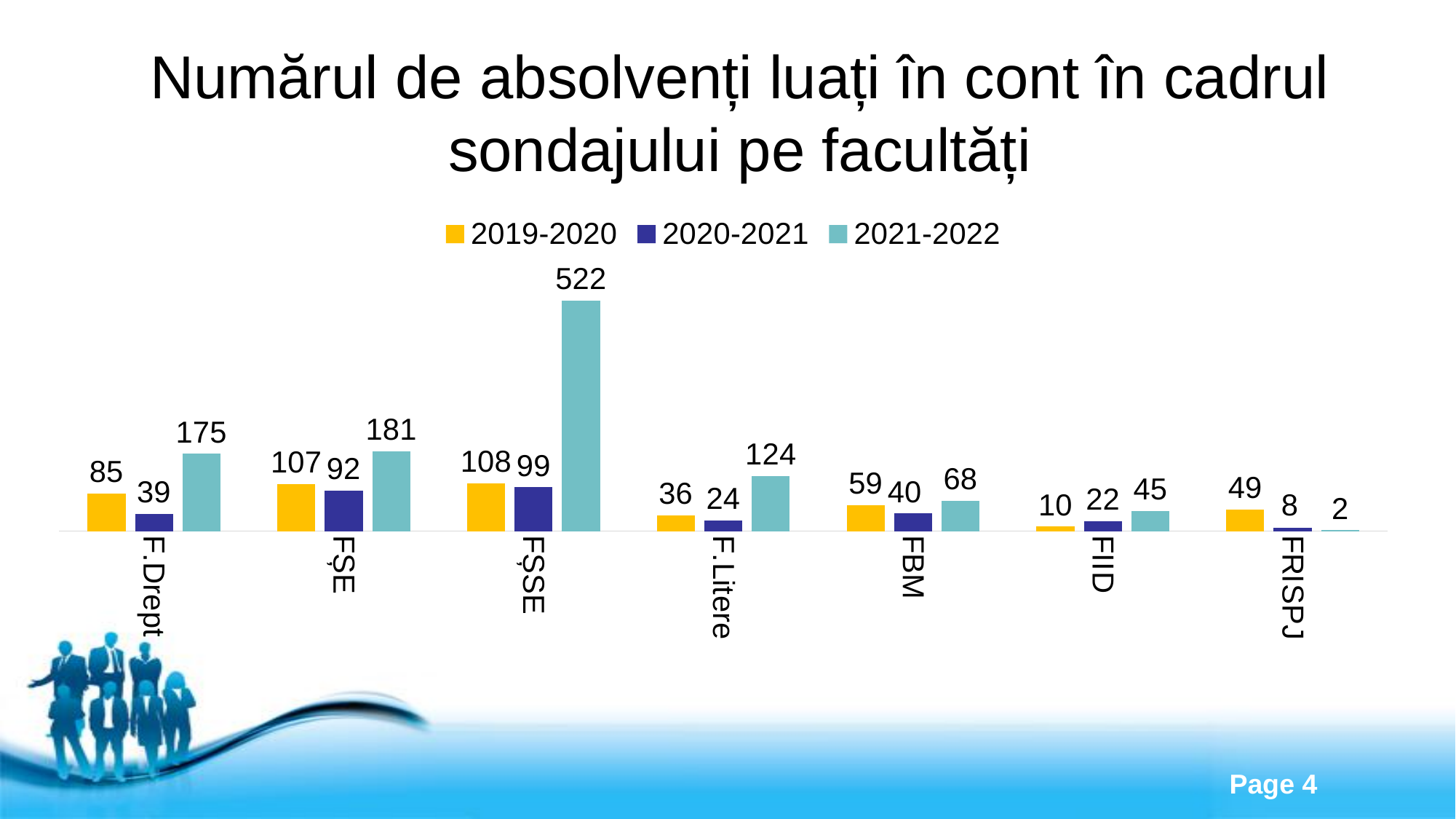
Which faculty has the lowest value in the 2019-2020 series? FIID What is the difference between the 2021-2022 and 2019-2020 values for F.Litere? 88 What is the value for FIID in the 2020-2021 series? 22 Which faculty has the highest value in the 2021-2022 series? FȘSE How many series does the legend list? 3 What kind of chart is shown on the slide? Bar chart What is the value for FȘSE in the 2021-2022 series? 522 What is the value for F.Drept in the 2019-2020 series? 85 Which is larger for FȘE: the 2019-2020 value or the 2020-2021 value? 2019-2020 How many faculties are shown on the x axis? 7 What is the total of the three series values for FRISPJ? 59 Which series is shown in yellow in the legend? 2019-2020